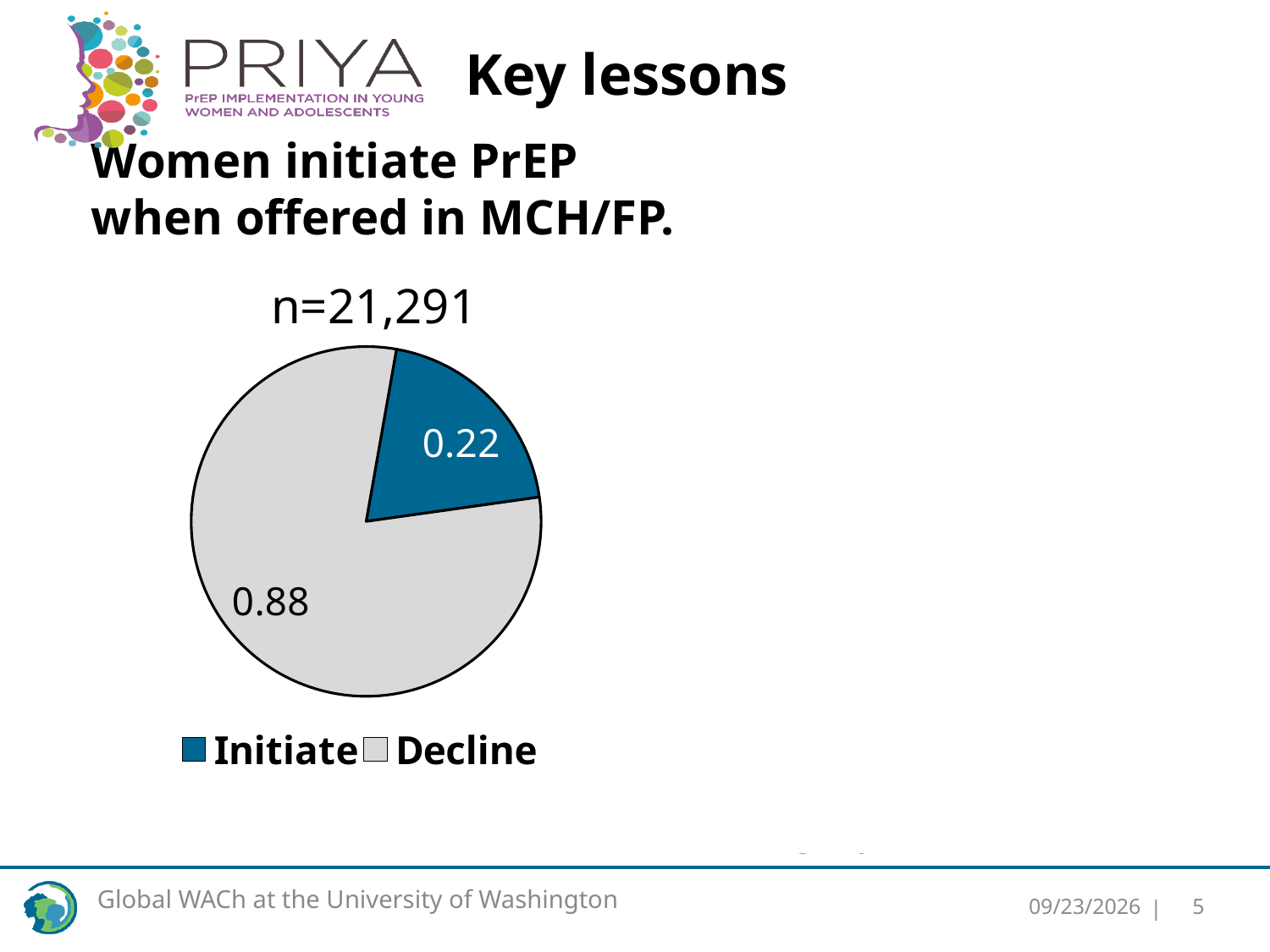
What is the value shown for the Initiate slice? 0.22 What is the value shown for the Decline slice? 0.88 What kind of chart is shown on the slide? pie chart What colour is the Initiate slice? blue What is the title shown above the pie chart? n=21,291 How many entries does the legend list? 2 Which is larger, the Initiate slice or the Decline slice? Decline What is the difference between the Decline value and the Initiate value? 0.66 Which slice of the pie is the smallest? Initiate How many slices does the pie chart have? 2 Which slice of the pie is the largest? Decline What share of the pie is labelled for Initiate? 0.22